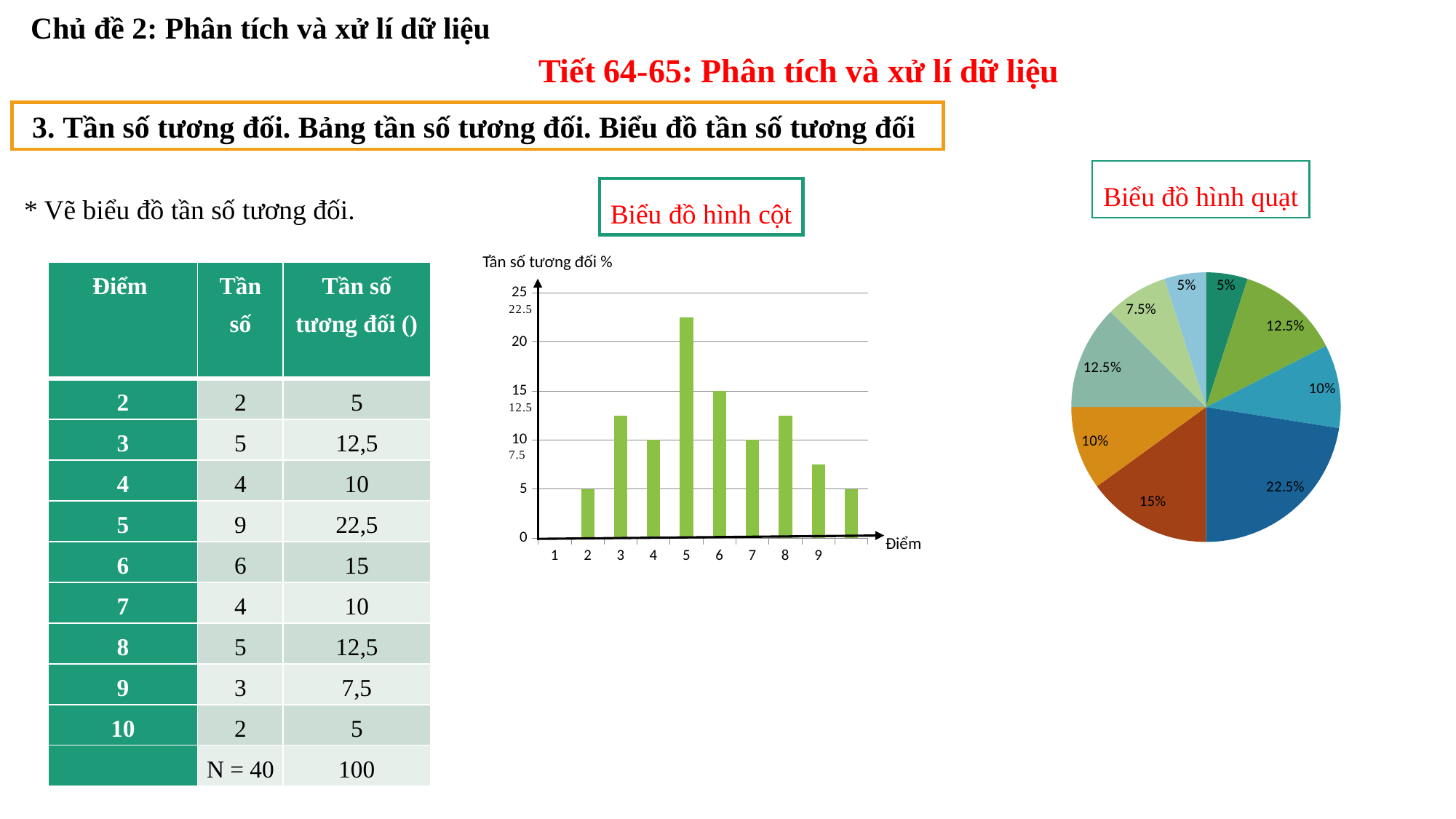
In the bar chart "Biểu đồ hình cột", which is larger, the value for Điểm 3 or Điểm 4? Điểm 3 In the bar chart "Biểu đồ hình cột", what is the difference between the values for Điểm 5 and Điểm 6? 7.5 What kind of chart is the chart titled "Biểu đồ hình quạt"? pie chart What kind of chart is the chart titled "Biểu đồ hình cột"? bar chart How many bars are plotted in the bar chart "Biểu đồ hình cột"? 9 How many slices does the pie chart "Biểu đồ hình quạt" have? 9 In the bar chart "Biểu đồ hình cột", is the value for Điểm 6 greater or less than 20? less In the bar chart "Biểu đồ hình cột", which Điểm has the highest bar? 5 What is the label of the vertical axis in the bar chart "Biểu đồ hình cột"? Tần số tương đối % In the pie chart "Biểu đồ hình quạt", what is the share of the largest slice? 22.5% In the bar chart "Biểu đồ hình cột", what is the value for Điểm 5? 22.5 In the bar chart "Biểu đồ hình cột", what is the value for Điểm 3? 12.5